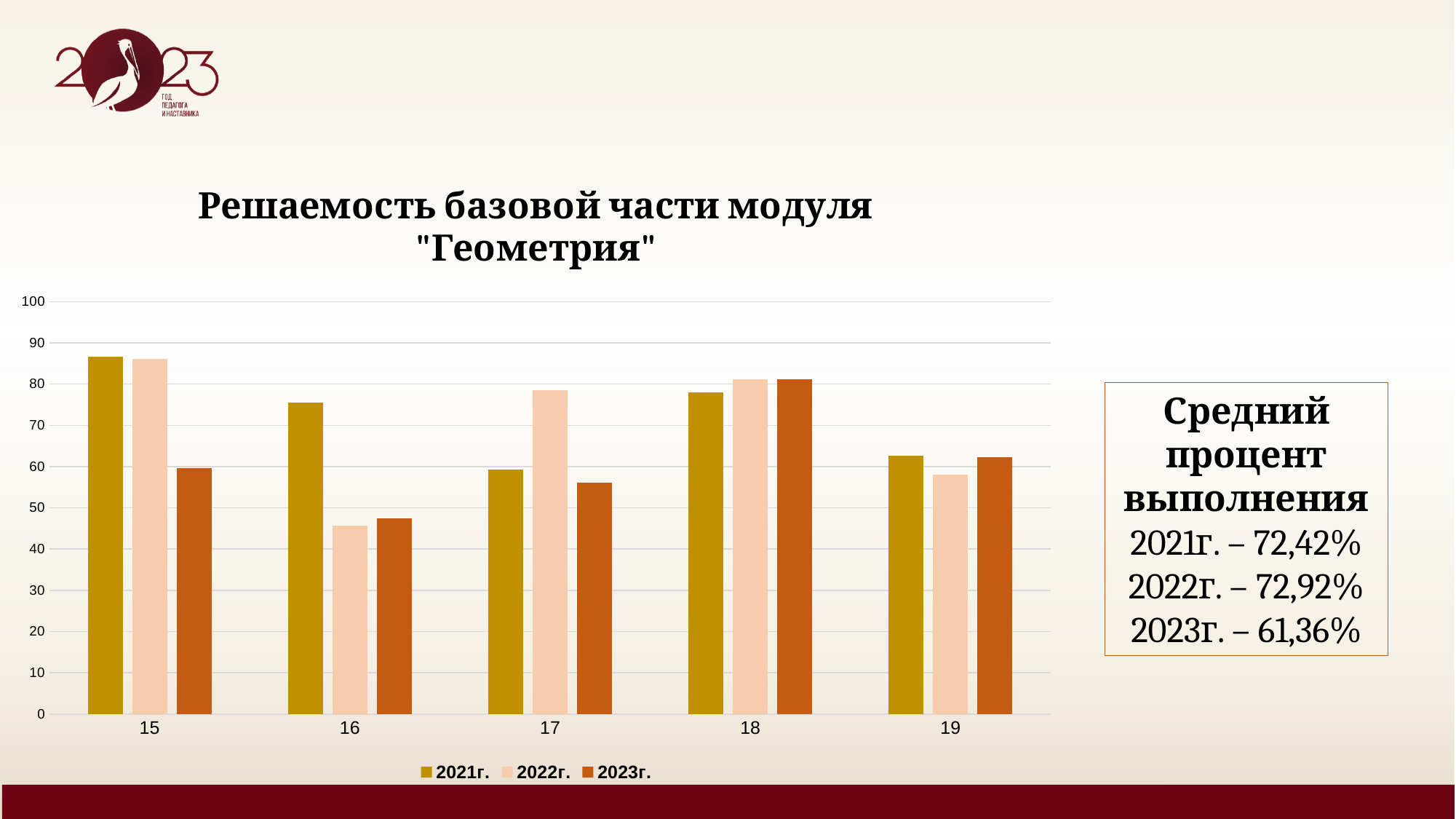
How many categories are shown on the x axis? 5 Is the value for 2022г. in category 17 greater or less than 70? greater For the 2023г. series, which category has the lowest value? 16 Is the value for 2021г. in category 16 greater or less than 70? greater For the 2021г. series, which category has the highest value? 15 What is the title of the chart? Решаемость базовой части модуля "Геометрия" In category 17, which series has the larger value, 2021г. or 2022г.? 2022г. What kind of chart is shown on the slide? bar chart How many series does the legend list? 3 For the 2022г. series, which category has the lowest value? 16 For the 2023г. series, which category has the highest value? 18 Is the value for 2022г. in category 16 greater or less than 50? less